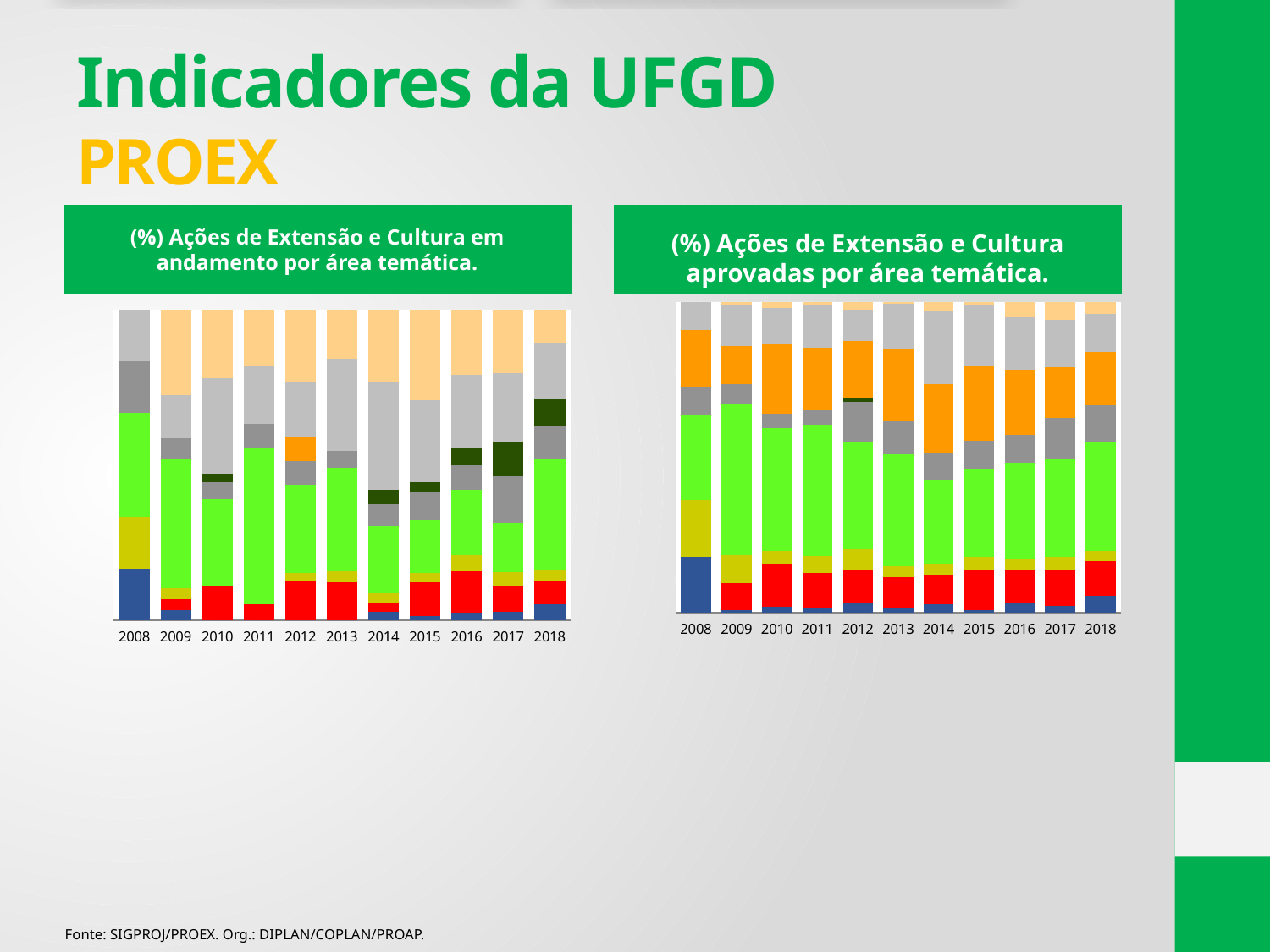
What type of chart is the right chart, '(%) Ações de Extensão e Cultura aprovadas por área temática'? Stacked bar chart In the left chart, '(%) Ações de Extensão e Cultura em andamento por área temática', how many years are shown on the x axis? 11 What type of chart is the left chart, '(%) Ações de Extensão e Cultura em andamento por área temática'? Stacked bar chart What is the title of the chart on the right of the slide? (%) Ações de Extensão e Cultura aprovadas por área temática. In the left chart, '(%) Ações de Extensão e Cultura em andamento por área temática', what is the first year on the x axis? 2008 In the right chart, '(%) Ações de Extensão e Cultura aprovadas por área temática', what is the last year on the x axis? 2018 What is the title of the chart on the left of the slide? (%) Ações de Extensão e Cultura em andamento por área temática. In the right chart, '(%) Ações de Extensão e Cultura aprovadas por área temática', how many bars are plotted? 11